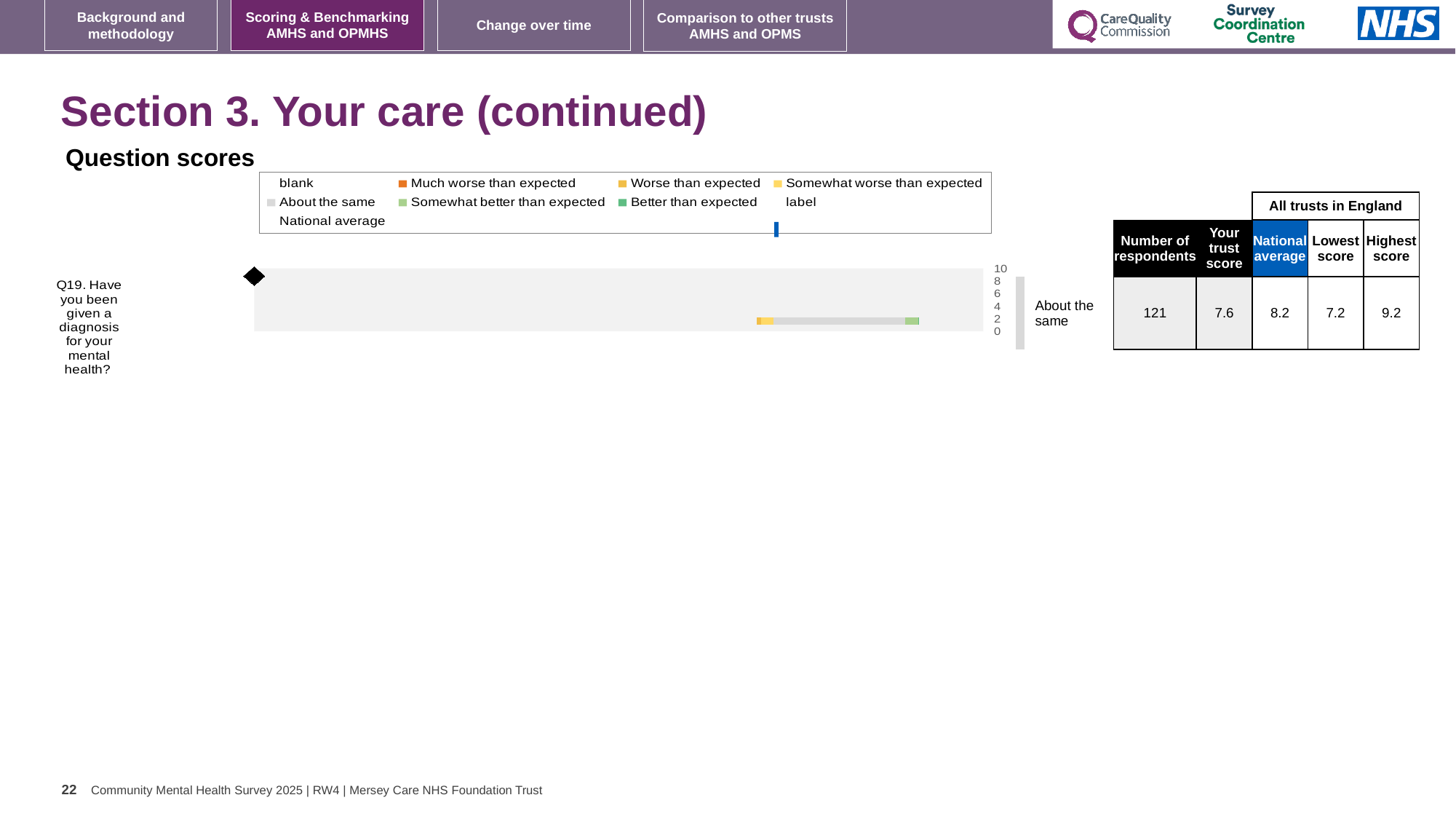
How many survey questions are plotted on the question scores chart? 1 How many respondents answered Q19? 121 What is the lowest score among all trusts in England for Q19? 7.2 Which survey question is plotted in the question scores chart? Q19. Have you been given a diagnosis for your mental health? What benchmark category is Q19 assigned to on the chart? About the same What is the highest score among all trusts in England for Q19? 9.2 What is the difference between the highest score and the lowest score for Q19? 2.0 Which is larger for Q19, the trust score or the national average? National average By how much does the national average exceed the trust score for Q19? 0.6 What is the trust score for Q19 shown in the table next to the chart? 7.6 What is the national average score for Q19? 8.2 What kind of chart is used to show the question scores? Bar chart